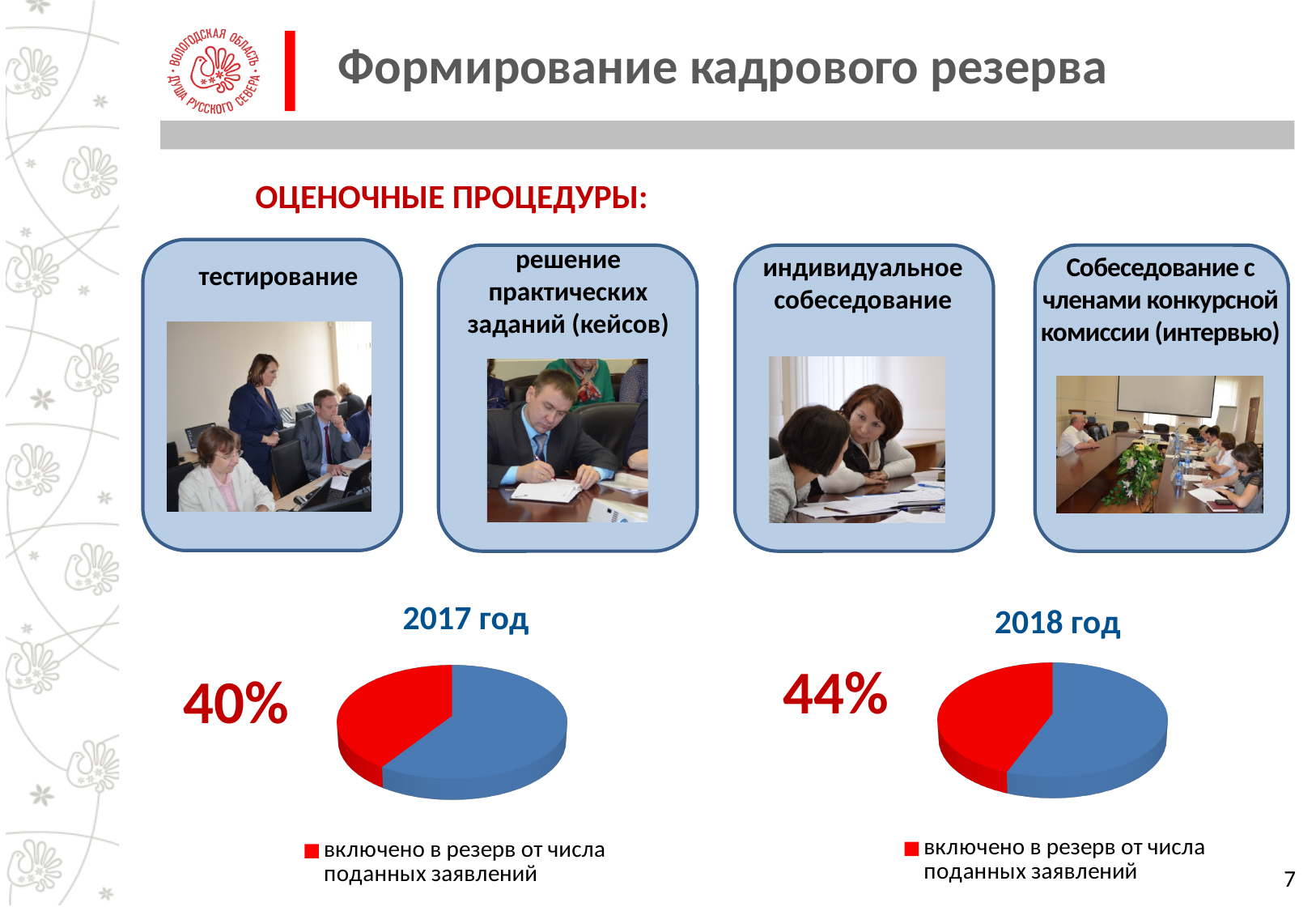
How many slices does the 2018 год pie chart have? 2 In the 2017 год chart, what share is shown for "включено в резерв от числа поданных заявлений"? 40% In the 2018 год chart, is the red slice larger or smaller than the blue slice? smaller What type of chart is used for the 2017 год chart? pie chart In the 2018 год chart, what share is shown for "включено в резерв от числа поданных заявлений"? 44% What colour represents "включено в резерв от числа поданных заявлений" in the 2018 год chart? red In the 2017 год chart, is the share for "включено в резерв от числа поданных заявлений" greater or less than 50%? less Which chart shows the larger share for "включено в резерв от числа поданных заявлений", 2017 год or 2018 год? 2018 год What is the title of the pie chart on the left side of the slide? 2017 год How many entries does the legend of the 2017 год chart list? 1 By how many percentage points does the share for "включено в резерв от числа поданных заявлений" in the 2018 год chart exceed that in the 2017 год chart? 4 percentage points